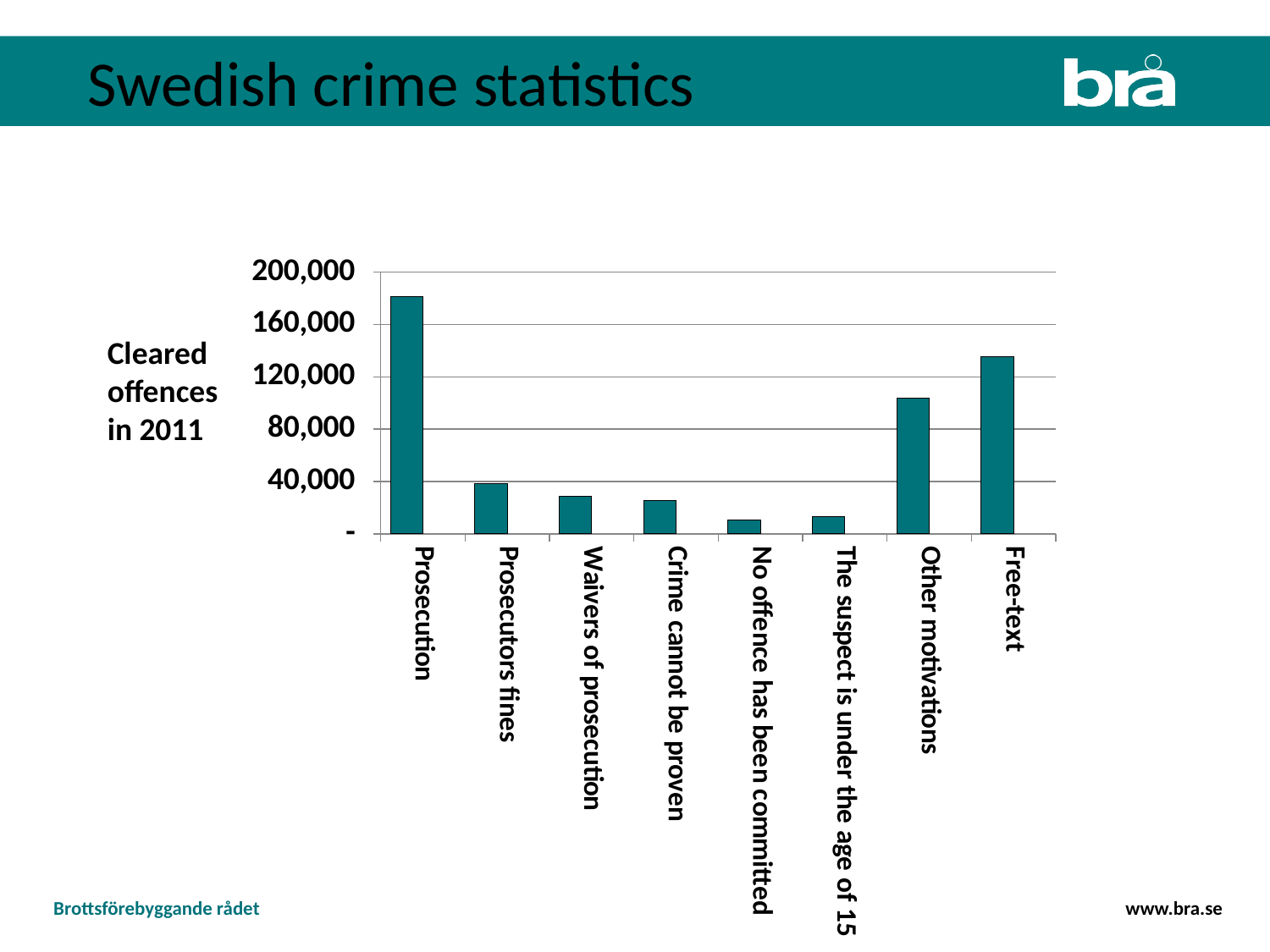
Which is larger, the value for Free-text or the value for Other motivations? Free-text What label describes the data shown in the chart, to the left of the y axis? Cleared offences in 2011 Is the value for Waivers of prosecution greater or less than 40,000? less Which is larger, the value for Prosecutors fines or the value for Waivers of prosecution? Prosecutors fines Is the value for Free-text greater or less than 120,000? greater Which is larger, the value for Prosecution or the value for Free-text? Prosecution How many categories are shown on the x axis of the chart? 8 Which category has the highest value in the chart? Prosecution Is the value for Prosecution greater or less than 160,000? greater What kind of chart is shown on the slide? bar chart